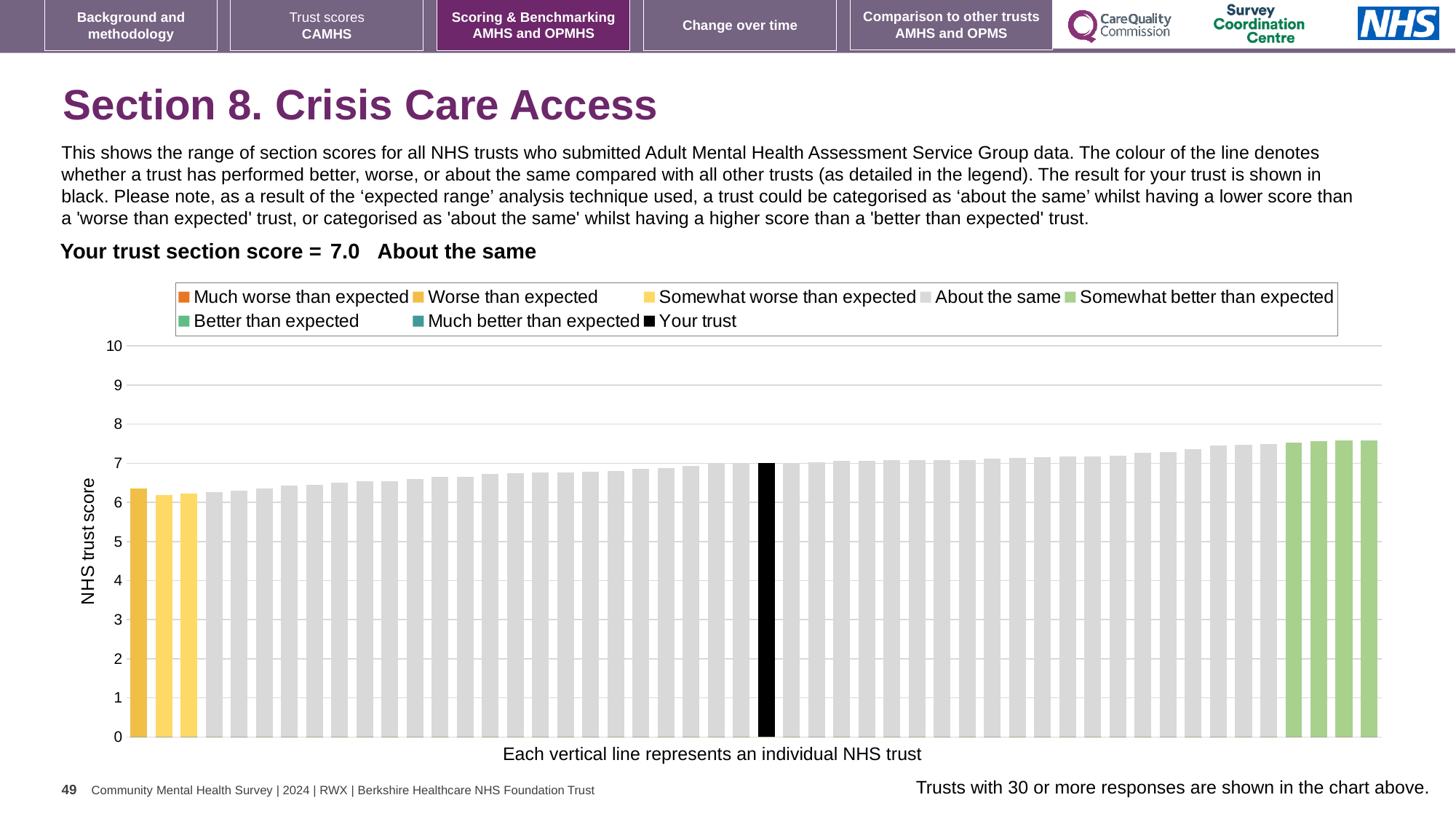
What is the label on the vertical axis of the chart? NHS trust score Is the rightmost bar higher or lower than the black 'Your trust' bar? higher Is the value of the rightmost bar greater or less than 8? less How many entries does the chart legend list? 8 How many bars are coloured green (Somewhat better than expected)? 4 What colour is used for the 'Your trust' bar in the chart? black What kind of chart is shown on the slide? bar chart Is the value of the black 'Your trust' bar greater or less than 5? greater Which category is your trust placed in for this section? About the same Is the value of the leftmost bar greater or less than 7? less Do the bar values rise or fall from left to right across the chart? rise What is the section score for your trust shown on the slide? 7.0